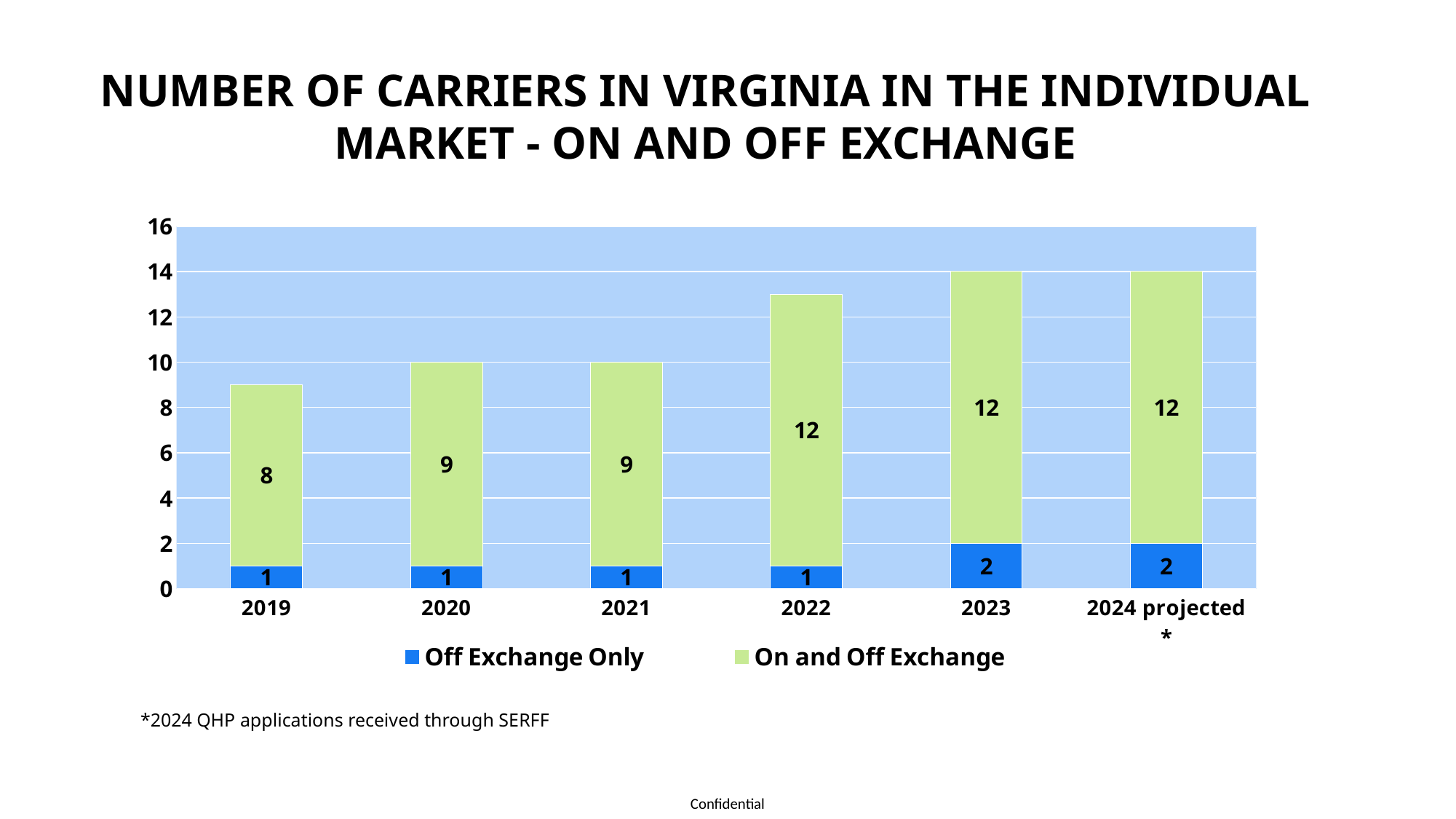
What is the total of the stacked bar for 2019? 9 What is the total of the stacked bar for 2023? 14 What is the value for On and Off Exchange in 2022? 12 How many series does the legend list? 2 What is the value for Off Exchange Only in 2023? 2 Is the Off Exchange Only value larger in 2024 projected or in 2021? 2024 projected Which year has the lowest value for On and Off Exchange? 2019 How many years are shown on the x axis? 6 Do the total number of carriers rise or fall from 2019 to 2023? Rise What is the difference between the On and Off Exchange values for 2022 and 2021? 3 What kind of chart is shown on the slide? Stacked bar chart What is the value for On and Off Exchange in 2019? 8